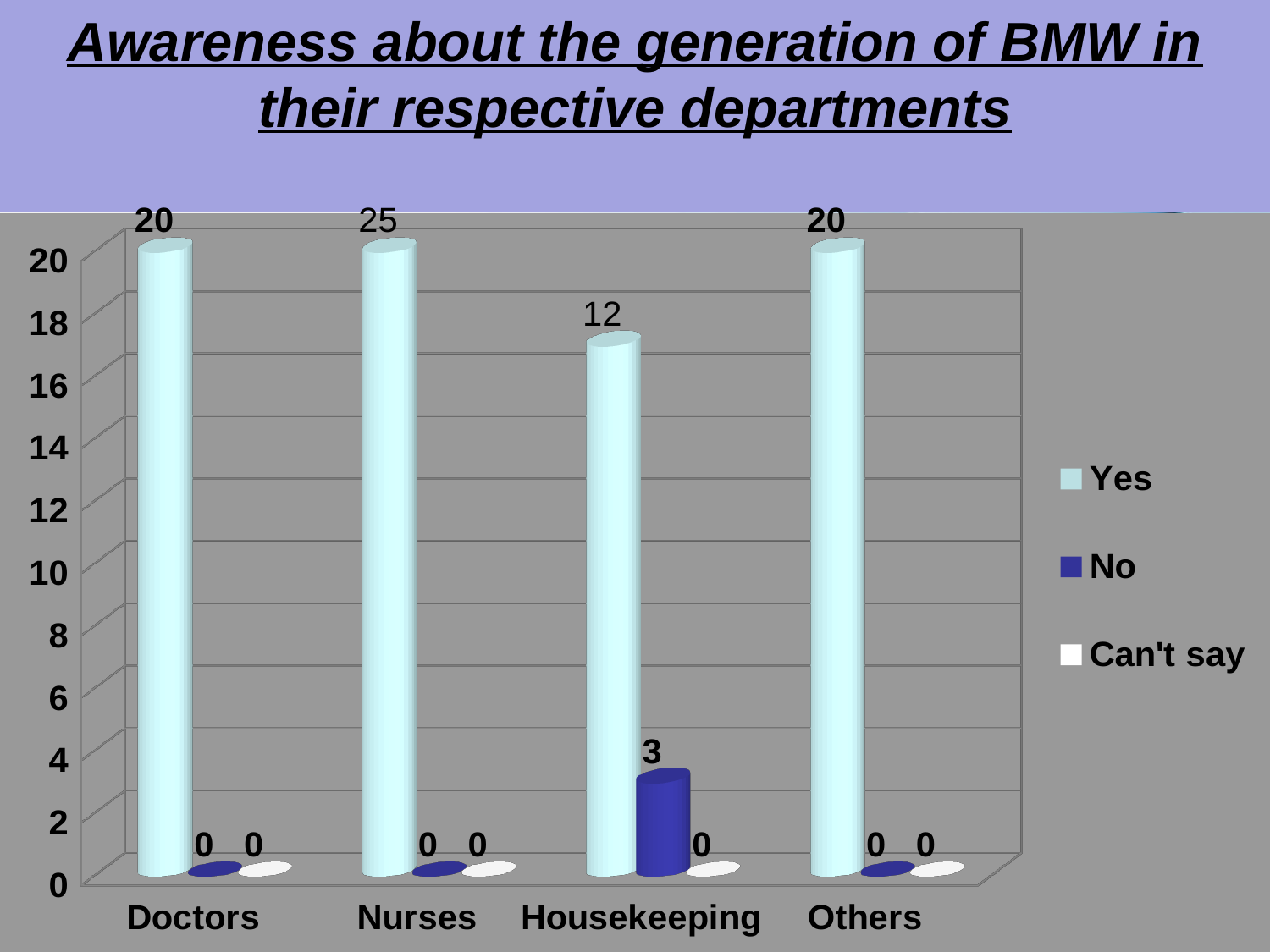
What kind of chart is shown on the slide? Bar chart Which is larger, the 'Yes' value for Nurses or the 'Yes' value for Others? Nurses How many series does the legend list? 3 What is the 'No' value for Housekeeping? 3 What is the 'Yes' value for Housekeeping? 12 What is the 'Yes' value for Doctors? 20 What is the difference between the 'Yes' values for Nurses and Housekeeping? 13 Which category has the lowest 'Yes' value? Housekeeping How many categories are shown on the x axis? 4 Which category has the highest 'No' value? Housekeeping What is the total of the 'Yes', 'No' and 'Can't say' values for Housekeeping? 15 What is the 'Yes' value for Nurses? 25